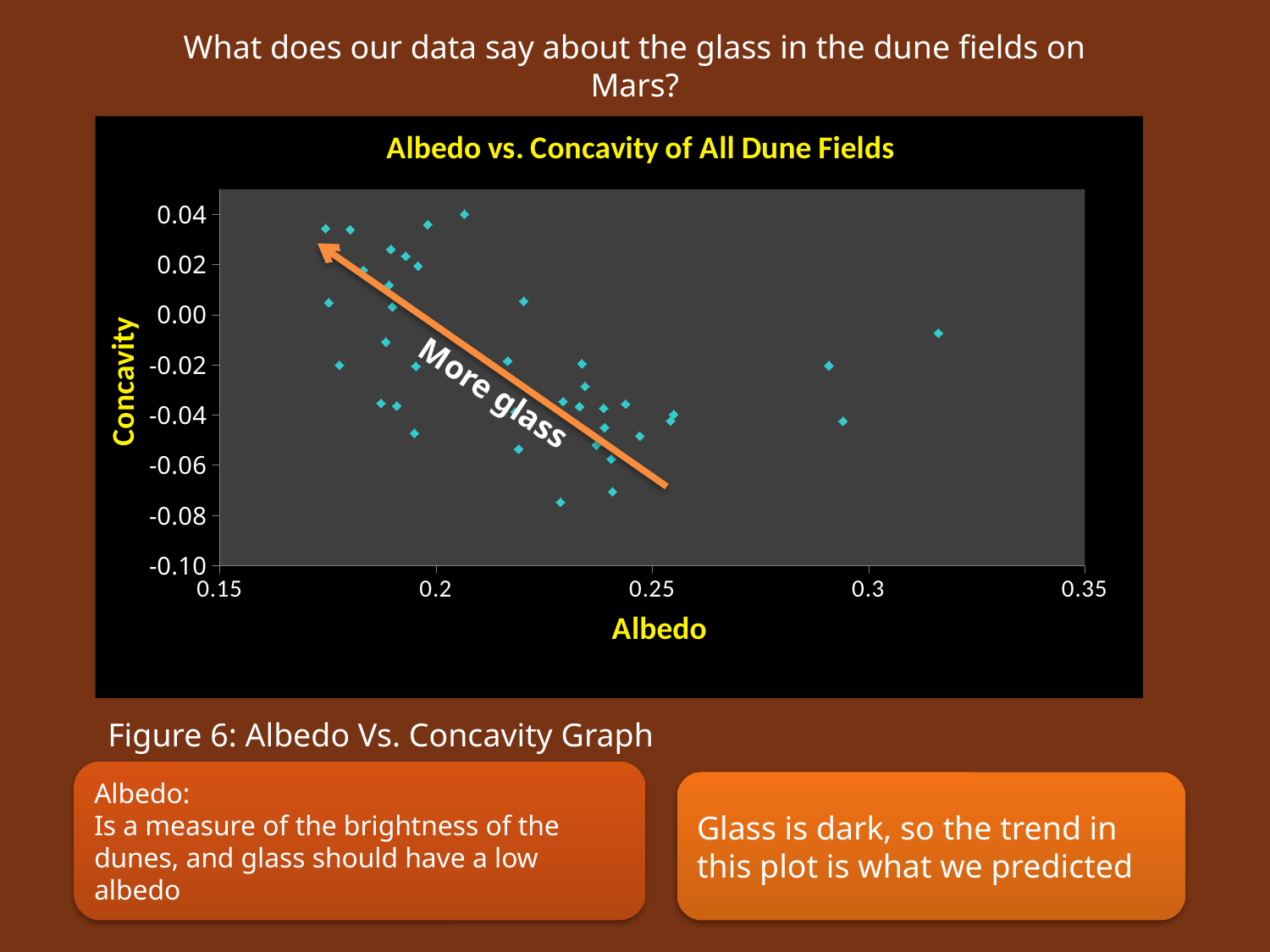
What text is written along the orange arrow in the chart? More glass As albedo increases along the x axis, does concavity generally rise or fall? fall Are there any points in the chart with albedo greater than 0.35? no What kind of chart is shown on the slide? scatter plot Is the concavity of the highest point in the chart greater or less than 0.02? greater Are there any points in the chart with concavity below -0.08? no What is the title of the chart? Albedo vs. Concavity of All Dune Fields